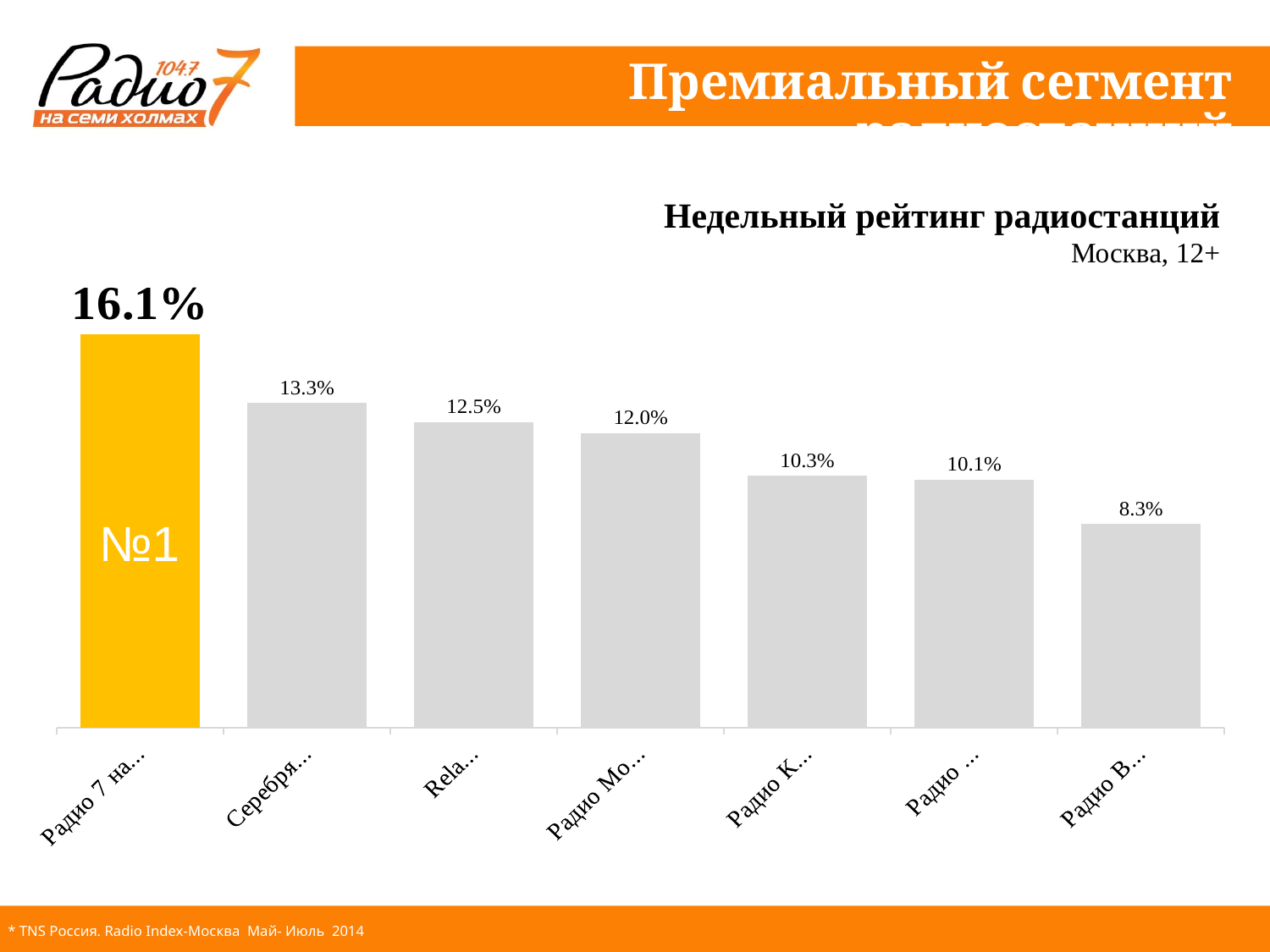
What is the title of the chart? Недельный рейтинг радиостанций What is the value of the bar labelled "Rela..."? 12.5% Do the bar values rise or fall from left to right across the chart? fall What is the value of the last bar on the right, labelled "Радио В..."? 8.3% Which bar has the highest value in the chart? Радио 7 на... (the first, orange bar) What is the difference between the first bar (16.1%) and the second bar (13.3%)? 2.8% What is the value of the second bar, labelled "Серебря..."? 13.3% Which is larger: the value of the bar labelled "Rela..." or the bar labelled "Радио Мо..."? Rela... What is the value of the first (orange) bar, labelled "Радио 7 на..."? 16.1% How many bars (radio stations) are plotted in the chart? 7 Which bar has the lowest value in the chart? Радио В... (the last bar) What type of chart is shown on the slide? bar chart